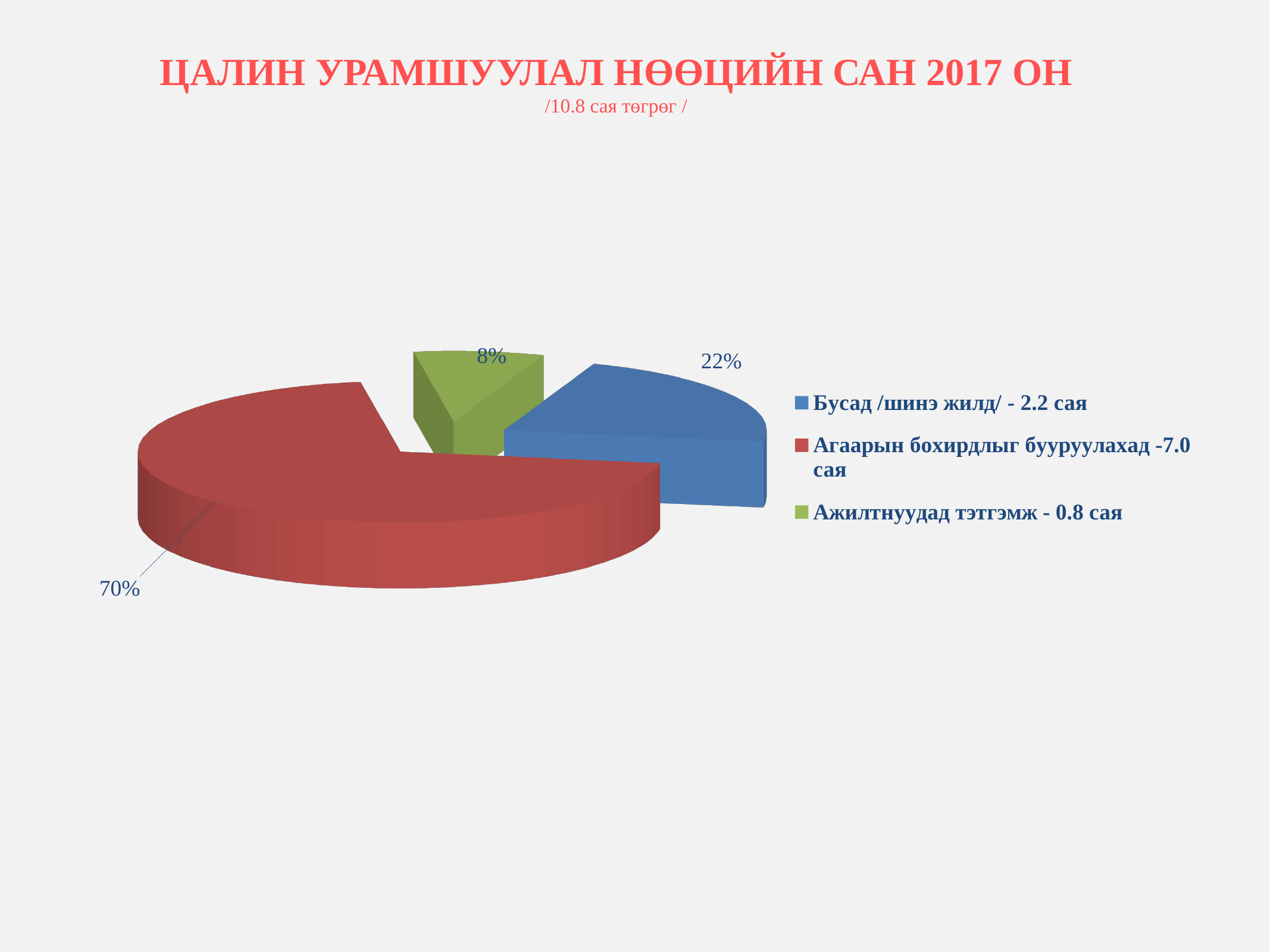
How many slices does the pie chart have? 3 What kind of chart is shown on the slide? Pie chart What percentage share does the slice for 'Бусад /шинэ жилд/ - 2.2 сая' have? 22% What is the difference in percentage points between the 'Бусад /шинэ жилд/' slice and the 'Ажилтнуудад тэтгэмж' slice? 14 Which slice is larger: 'Бусад /шинэ жилд/ - 2.2 сая' or 'Ажилтнуудад тэтгэмж - 0.8 сая'? Бусад /шинэ жилд/ - 2.2 сая What colour is the slice for 'Ажилтнуудад тэтгэмж - 0.8 сая'? Green What percentage share does the slice for 'Ажилтнуудад тэтгэмж - 0.8 сая' have? 8% What is the difference in percentage points between the 70% slice and the 22% slice? 48 Which category has the largest share of the pie? Агаарын бохирдлыг бууруулахад -7.0 сая Which category has the smallest share of the pie? Ажилтнуудад тэтгэмж - 0.8 сая What is the title of the slide? ЦАЛИН УРАМШУУЛАЛ НӨӨЦИЙН САН 2017 ОН What percentage share does the slice for 'Агаарын бохирдлыг бууруулахад -7.0 сая' have? 70%